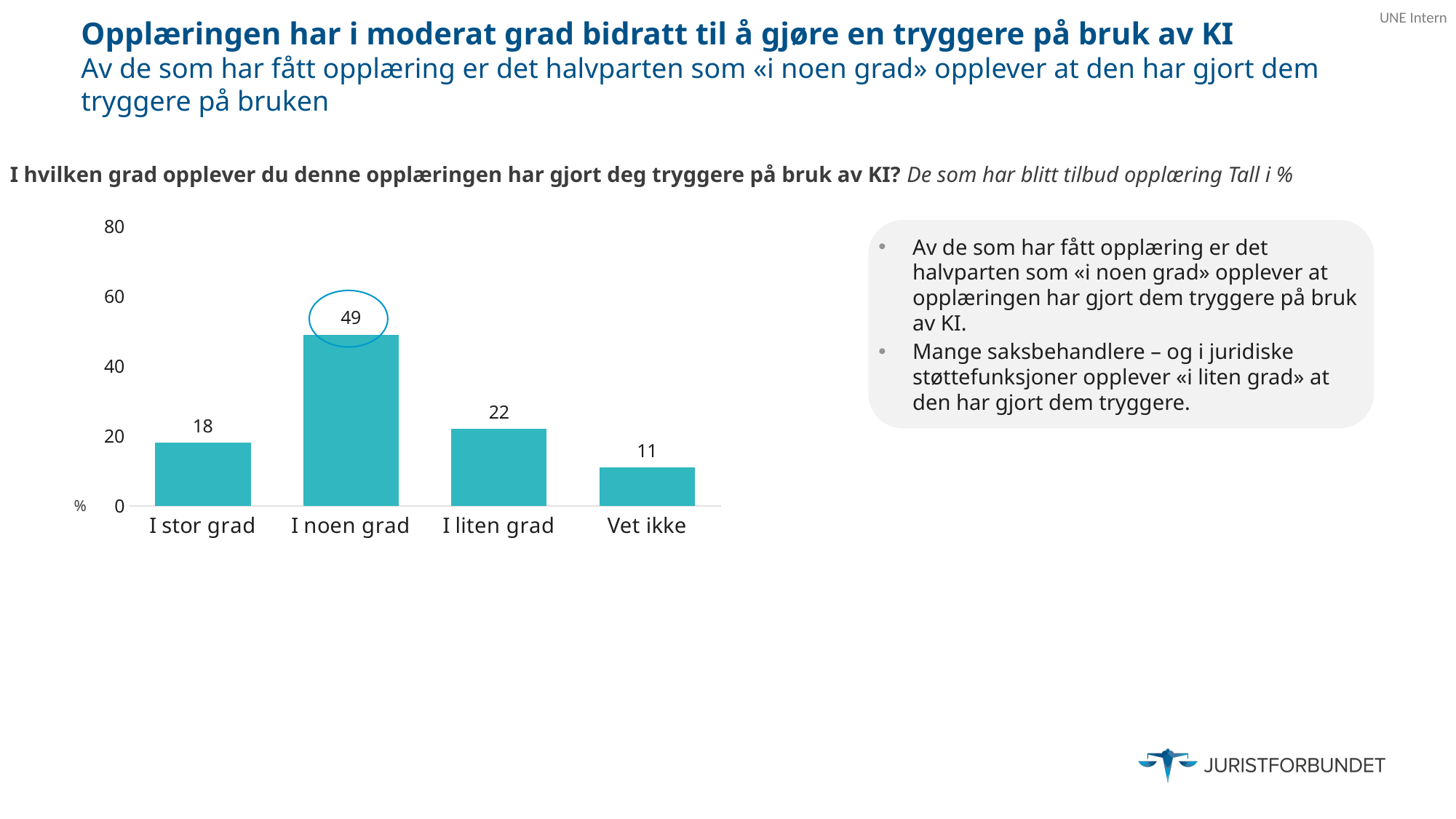
What is the difference between the values for "I noen grad" and "I liten grad"? 27 What is the value for "I stor grad"? 18 What is the value for "I liten grad"? 22 Which is larger, the value for "I liten grad" or "I stor grad"? I liten grad Which category has the lowest value? Vet ikke How many categories are shown on the x axis? 4 Is the value for "I noen grad" greater or less than 40? greater What is the value for "I noen grad"? 49 What is the highest tick value shown on the vertical axis? 80 What kind of chart is shown on the slide? bar chart Which category has the highest value? I noen grad What is the value for "Vet ikke"? 11